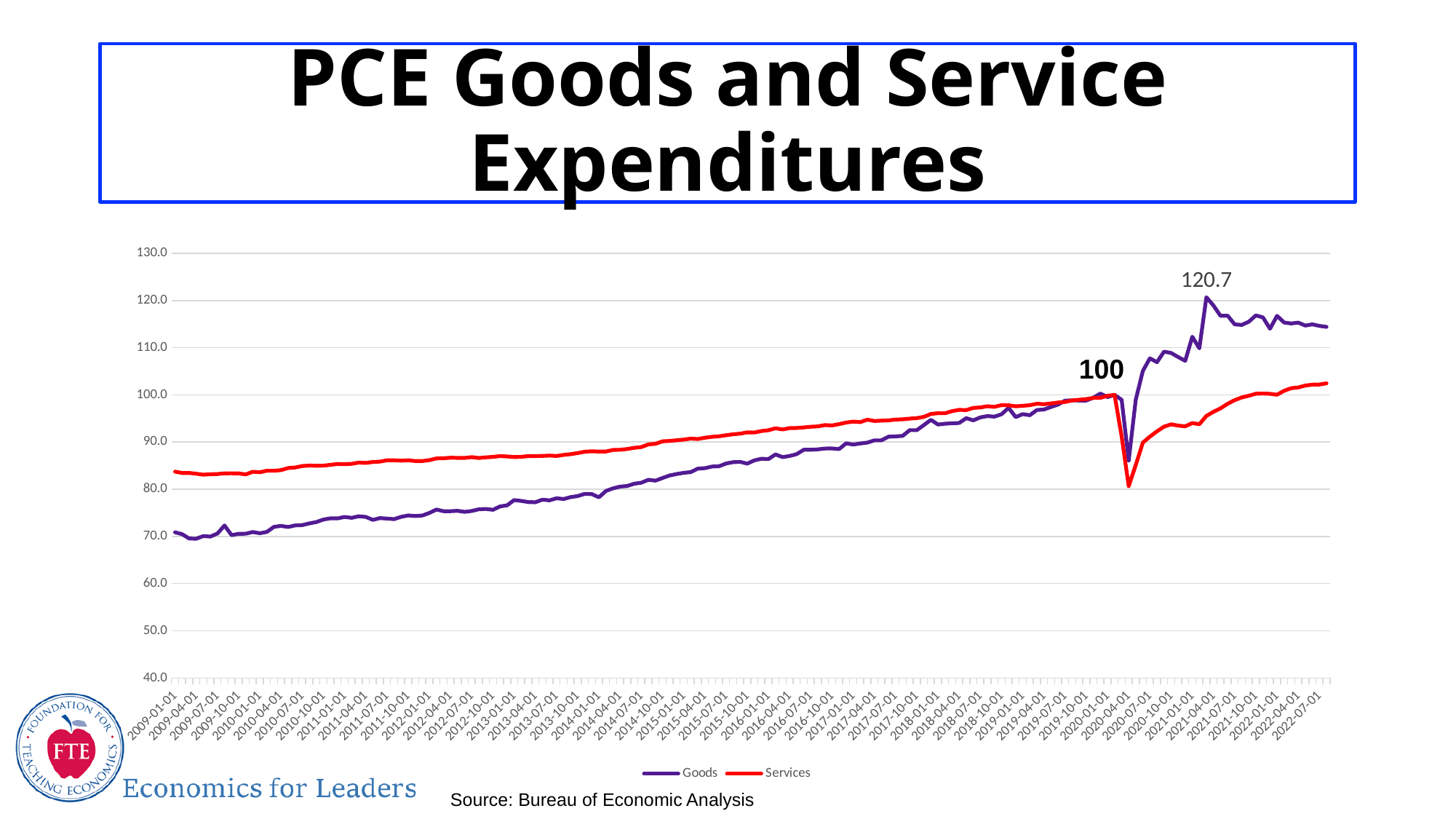
What are the two series named in the legend? Goods and Services Does the Services line generally rise or fall from 2009 to 2019? rise What value is labelled on the chart at the start of 2020, where the two lines meet? 100 Is the value for Goods at 2009-01-01 greater or less than 80? less At 2022-07-01, which series has the higher value, Goods or Services? Goods How many series does the legend list? 2 At 2015-01-01, which series has the higher value, Goods or Services? Services Is the value for Services at 2009-01-01 greater or less than 80? greater Is the lowest value of the Services line during 2020 greater or less than 90? less What is the peak value labelled on the Goods line? 120.7 What kind of chart is shown on the slide? line chart Which series reaches the higher peak value on the chart? Goods